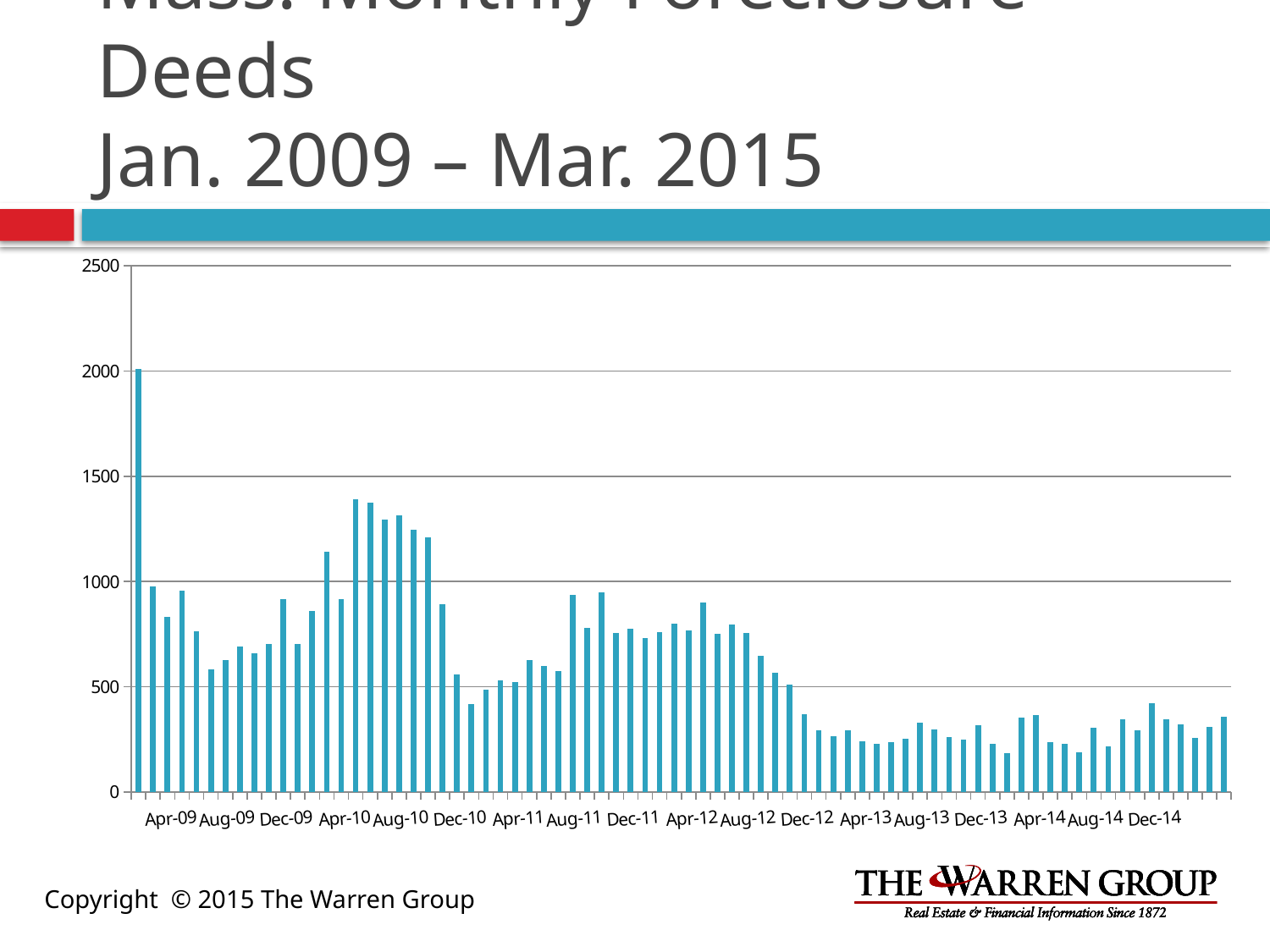
Is the value for Apr-09 greater or less than 1000? less Overall, do the values rise or fall from the left of the x axis to the right? fall Which is larger, the value for Aug-10 or the value for Dec-10? Aug-10 Is the value for Apr-12 greater or less than 500? greater What kind of chart is shown on the slide? bar chart What is the highest value shown on the vertical axis? 2500 Is the value for Apr-13 greater or less than 500? less Which is larger, the value for Apr-10 or the value for Apr-13? Apr-10